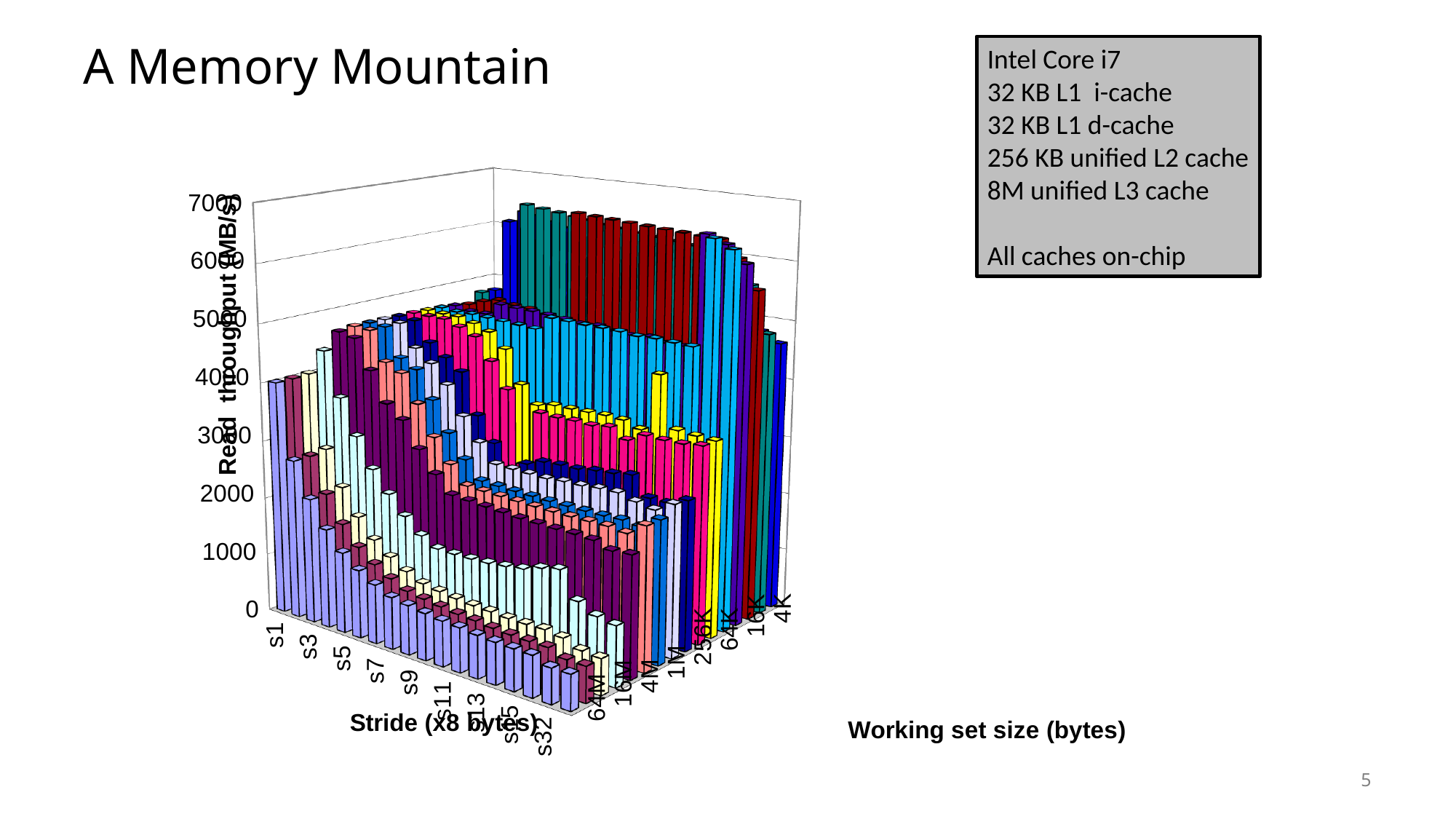
Which working set size has the higher read throughput at stride s1: 4K or 64M? 4K What is the label of the vertical axis of the chart? Read throughput (MB/s) Is the read throughput for stride s1 at a working set size of 64M greater or less than 3000? greater For a working set size of 64M, does read throughput rise or fall as the stride increases from s1 to s32? fall Is the read throughput for stride s1 at a working set size of 4K greater or less than 6000? less What is the highest tick value shown on the vertical axis of the chart? 7000 Is the read throughput for stride s32 at a working set size of 64M greater or less than 3000? less For stride s1, does read throughput rise or fall as the working set size decreases from 64M to 4K? rise How many stride labels are shown along the front axis of the chart? 9 What kind of chart is shown on the slide? 3D bar chart What is the title of the chart on the slide? A Memory Mountain How many working set size labels are shown along the depth axis of the chart? 8